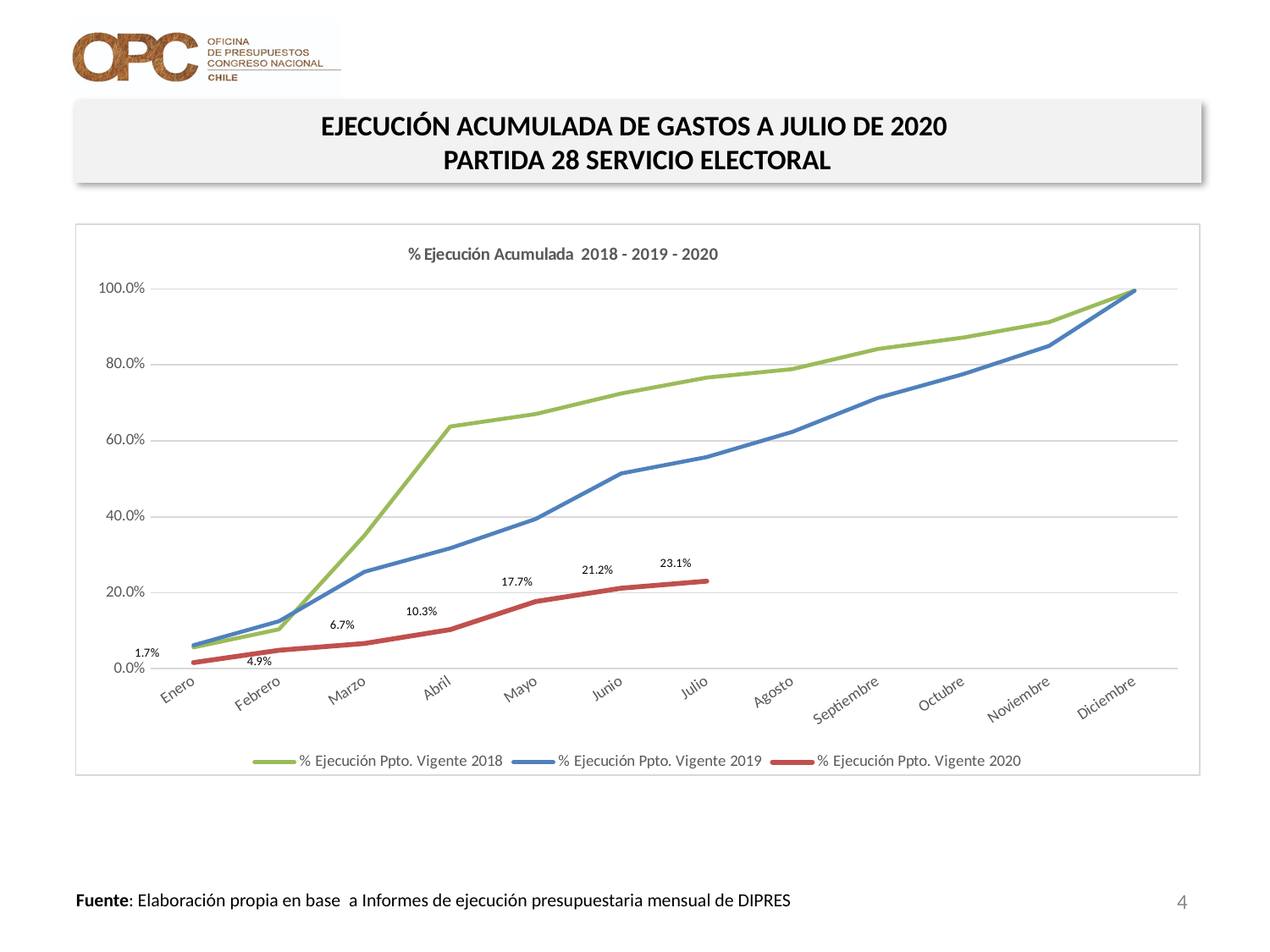
How many months are shown on the x axis of the chart? 12 What kind of chart is shown on the slide? Line chart What is the difference between the 2020 values for Mayo and Abril? 7.4% How many series does the chart legend list? 3 By how many percentage points did % Ejecución Ppto. Vigente 2020 increase from Junio to Julio? 1.9% Does the % Ejecución Ppto. Vigente 2020 series rise or fall from Enero to Julio? Rise In which month does the % Ejecución Ppto. Vigente 2020 series reach its highest labelled value? Julio In Abril, which series is higher: % Ejecución Ppto. Vigente 2018 or % Ejecución Ppto. Vigente 2019? % Ejecución Ppto. Vigente 2018 What is the value of % Ejecución Ppto. Vigente 2020 in Enero? 1.7% Is the value for % Ejecución Ppto. Vigente 2019 in Junio greater or less than 40.0%? greater What is the value of % Ejecución Ppto. Vigente 2020 in Abril? 10.3% What is the value of % Ejecución Ppto. Vigente 2020 in Julio? 23.1%